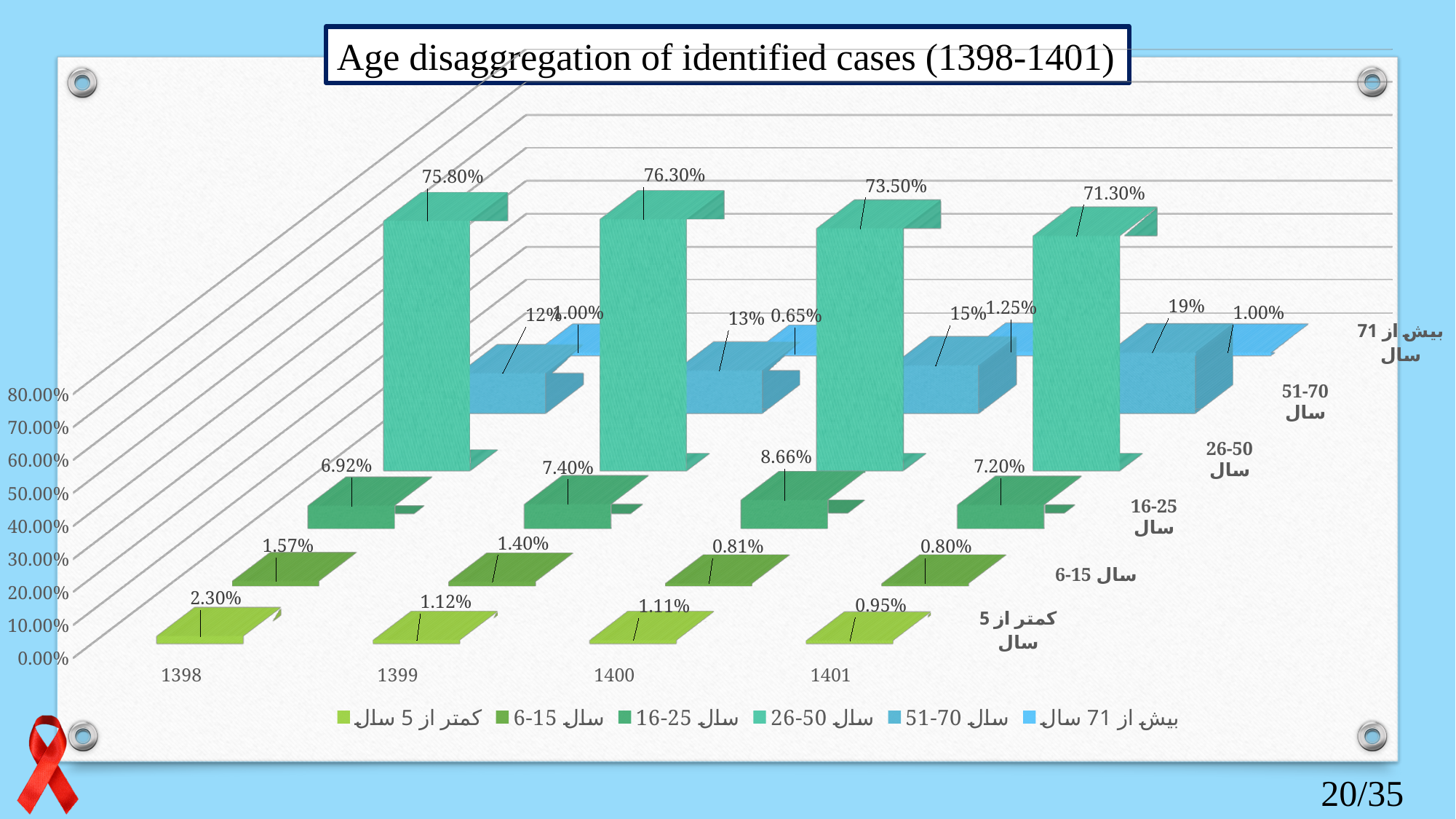
How many series does the legend list? 6 What is the value for the 16-25 age group in 1400? 8.66% What is the value for the under-5 age group in 1398? 2.30% What is the title of the chart? Age disaggregation of identified cases (1398-1401) In which year is the value for the 51-70 age group lowest? 1398 Does the value for the 51-70 age group rise or fall from 1398 to 1401? rise What is the value for the 26-50 age group in 1399? 76.30% What type of chart is shown on the slide? bar chart In which year is the value for the 26-50 age group highest? 1399 How many years are shown on the x axis? 4 What is the difference between the 26-50 age group values in 1398 and 1401? 4.50% What is the value for the 51-70 age group in 1401? 19%